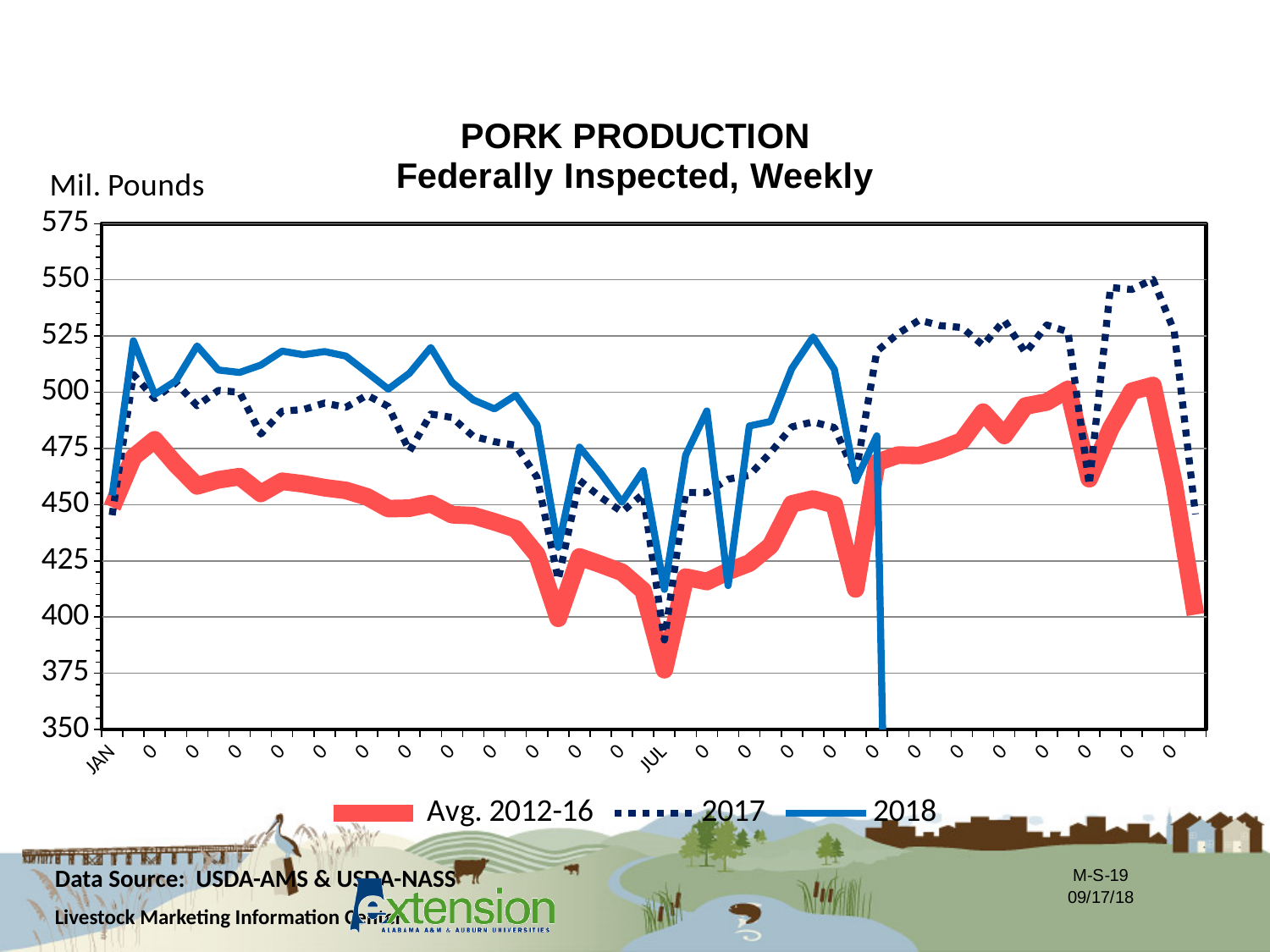
Is the value for the Avg. 2012-16 series at JUL greater or less than 400? less Is the value for the 2017 series at JUL greater or less than 400? less Does the Avg. 2012-16 series generally rise or fall from JAN to JUL? fall Which series reaches the highest value anywhere on the chart? 2017 How many series does the legend list? 3 What unit is shown on the y axis? Mil. Pounds Is the value for the 2018 series at JUL greater or less than 425? less In the weeks just after JAN, which series is higher, 2018 or 2017? 2018 Which series is drawn as a dotted line? 2017 What kind of chart is shown on the slide? line chart